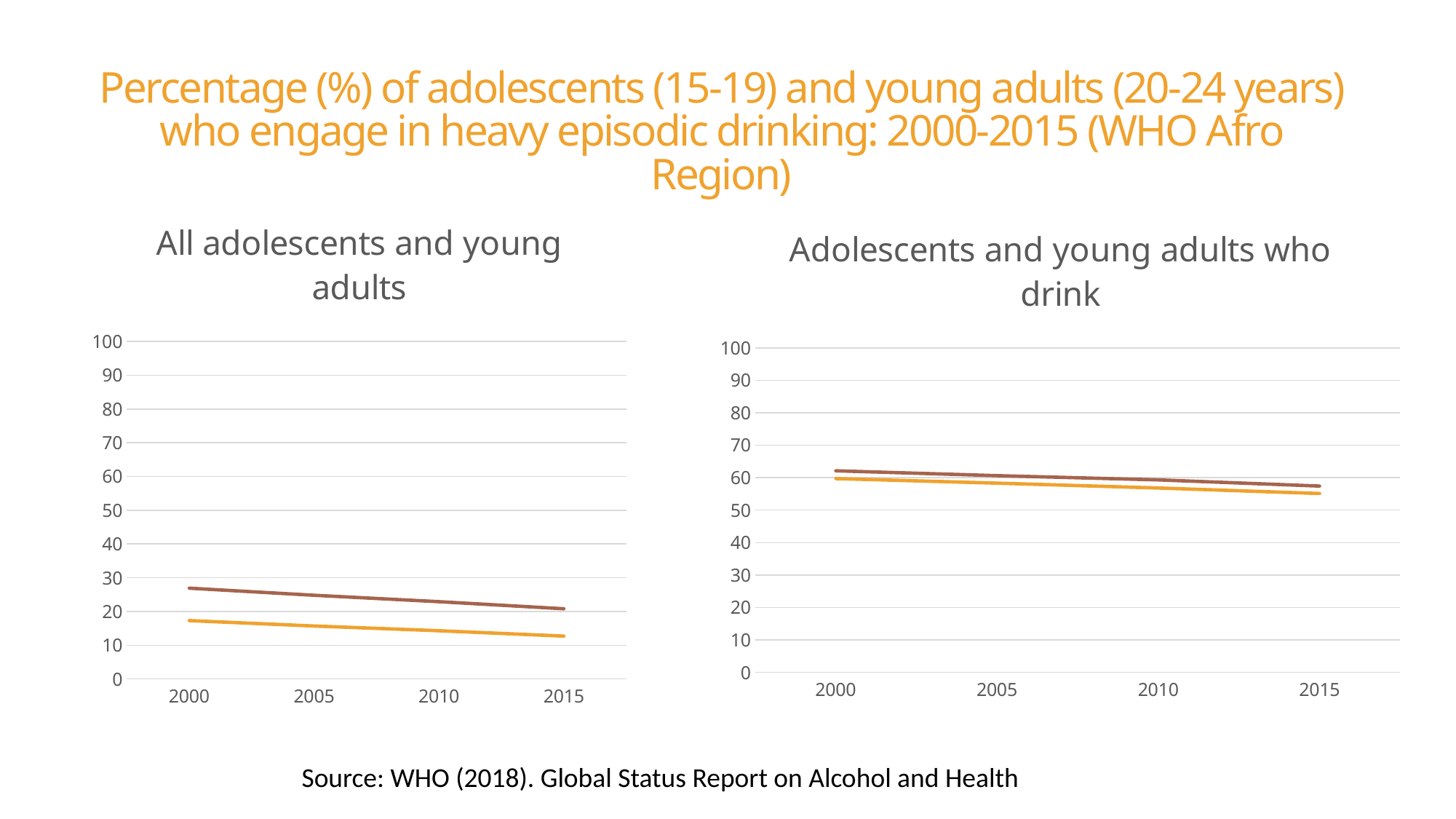
What is the title of the chart on the right side of the slide? Adolescents and young adults who drink In the left chart 'All adolescents and young adults', how many years are labelled on the x axis? 4 In the left chart 'All adolescents and young adults', is the value of the orange line in 2015 greater or less than 20? less In the right chart 'Adolescents and young adults who drink', which line is higher in 2000, the brown line or the orange line? the brown line In the right chart 'Adolescents and young adults who drink', is the value of the brown line in 2000 greater or less than 50? greater In the left chart 'All adolescents and young adults', do the lines rise or fall from 2000 to 2015? fall In the left chart 'All adolescents and young adults', is the value of the brown line in 2000 greater or less than 20? greater In the right chart 'Adolescents and young adults who drink', do the lines rise or fall from 2000 to 2015? fall What kind of chart is the left chart titled 'All adolescents and young adults'? line chart In the left chart 'All adolescents and young adults', which line is higher in 2000, the brown line or the orange line? the brown line What is the highest value shown on the y axis of the left chart 'All adolescents and young adults'? 100